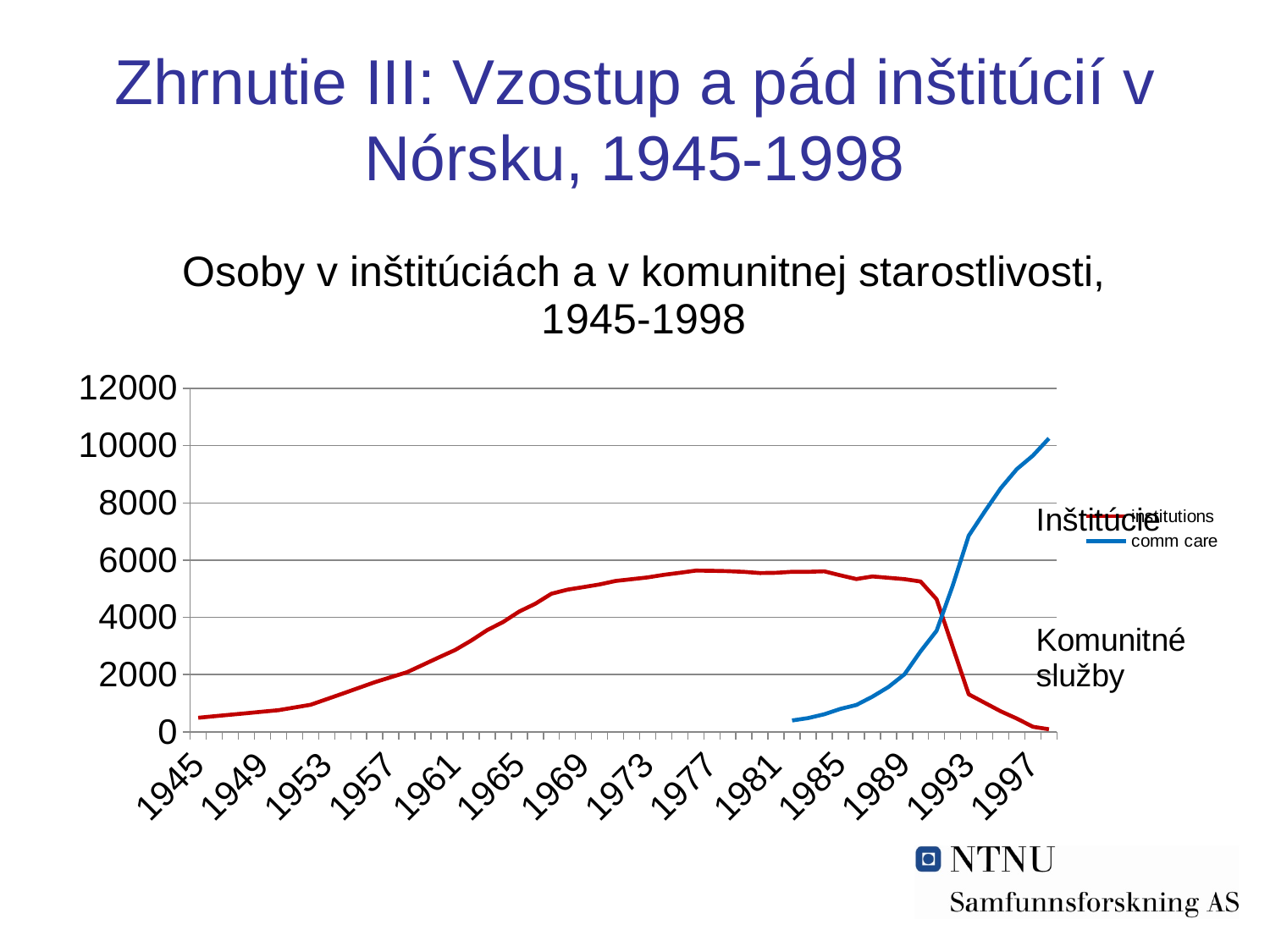
Is the value for institutions in 1977 greater or less than 4000? greater Is the value for institutions in 1997 greater or less than 2000? less Is the value for institutions in 1945 greater or less than 2000? less In 1985, which series has the larger value, institutions or comm care? institutions What is the title of the chart? Osoby v inštitúciách a v komunitnej starostlivosti, 1945-1998 What kind of chart is shown on the slide? line chart In 1997, which series has the larger value, institutions or comm care? comm care Does the institutions series rise or fall between 1989 and 1997? fall What are the two series named in the chart's legend? institutions and comm care How many series does the chart's legend list? 2